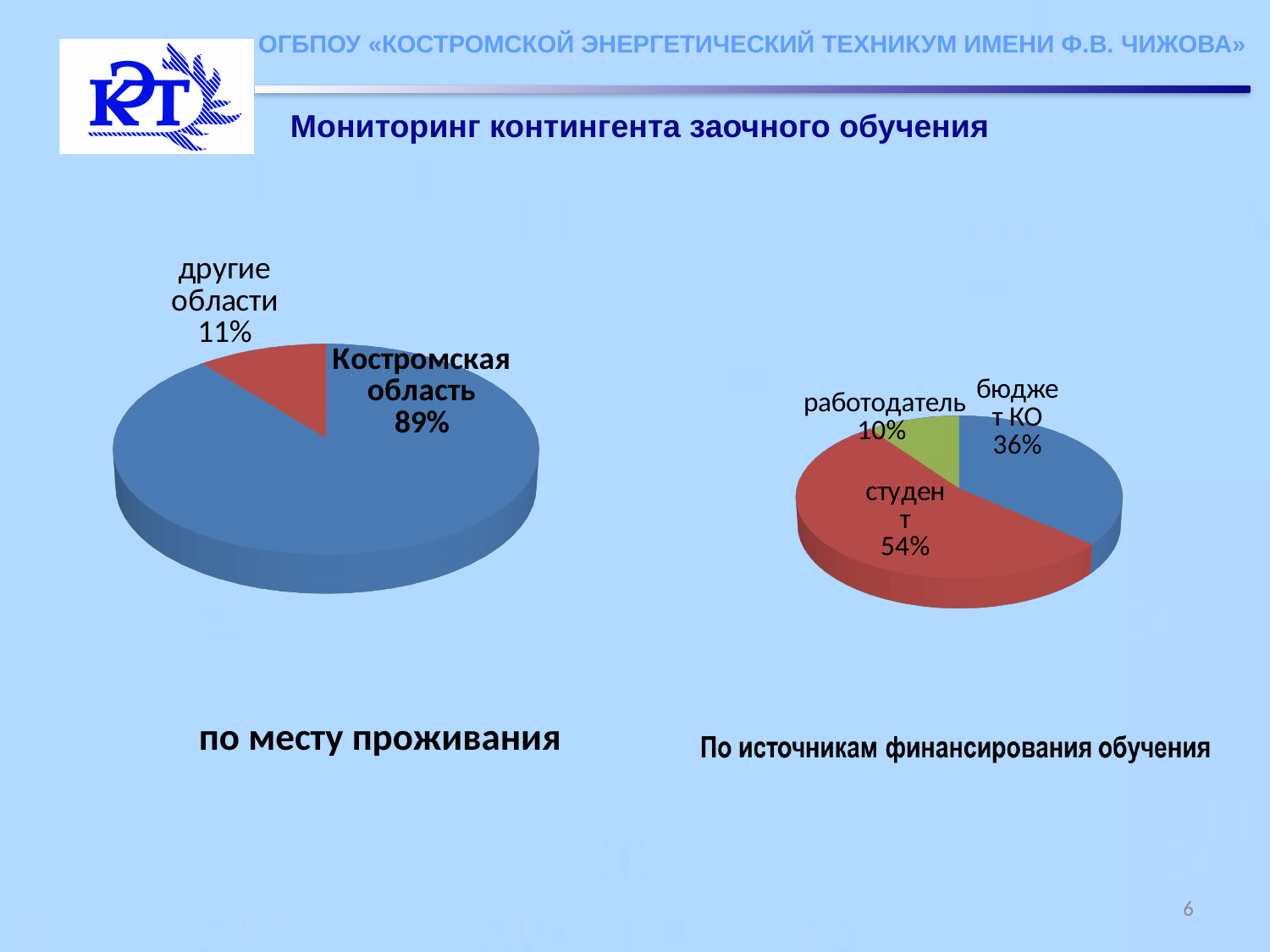
In the chart 'По источникам финансирования обучения', which is larger: студент or бюджет КО? студент In the chart 'По источникам финансирования обучения', what is the difference in percentage points between студент and работодатель? 44 In the chart 'по месту проживания', what is the difference in percentage points between Костромская область and другие области? 78 What type of chart is 'По источникам финансирования обучения'? pie chart In the chart 'по месту проживания', what share is labelled for Костромская область? 89% In the chart 'По источникам финансирования обучения', what share is labelled for бюджет КО? 36% How many slices does the chart 'по месту проживания' have? 2 How many slices does the chart 'По источникам финансирования обучения' have? 3 In the chart 'По источникам финансирования обучения', what share is labelled for студент? 54% In the chart 'по месту проживания', which category has the largest slice? Костромская область In the chart 'по месту проживания', what share is labelled for другие области? 11% In the chart 'По источникам финансирования обучения', which category has the smallest slice? работодатель